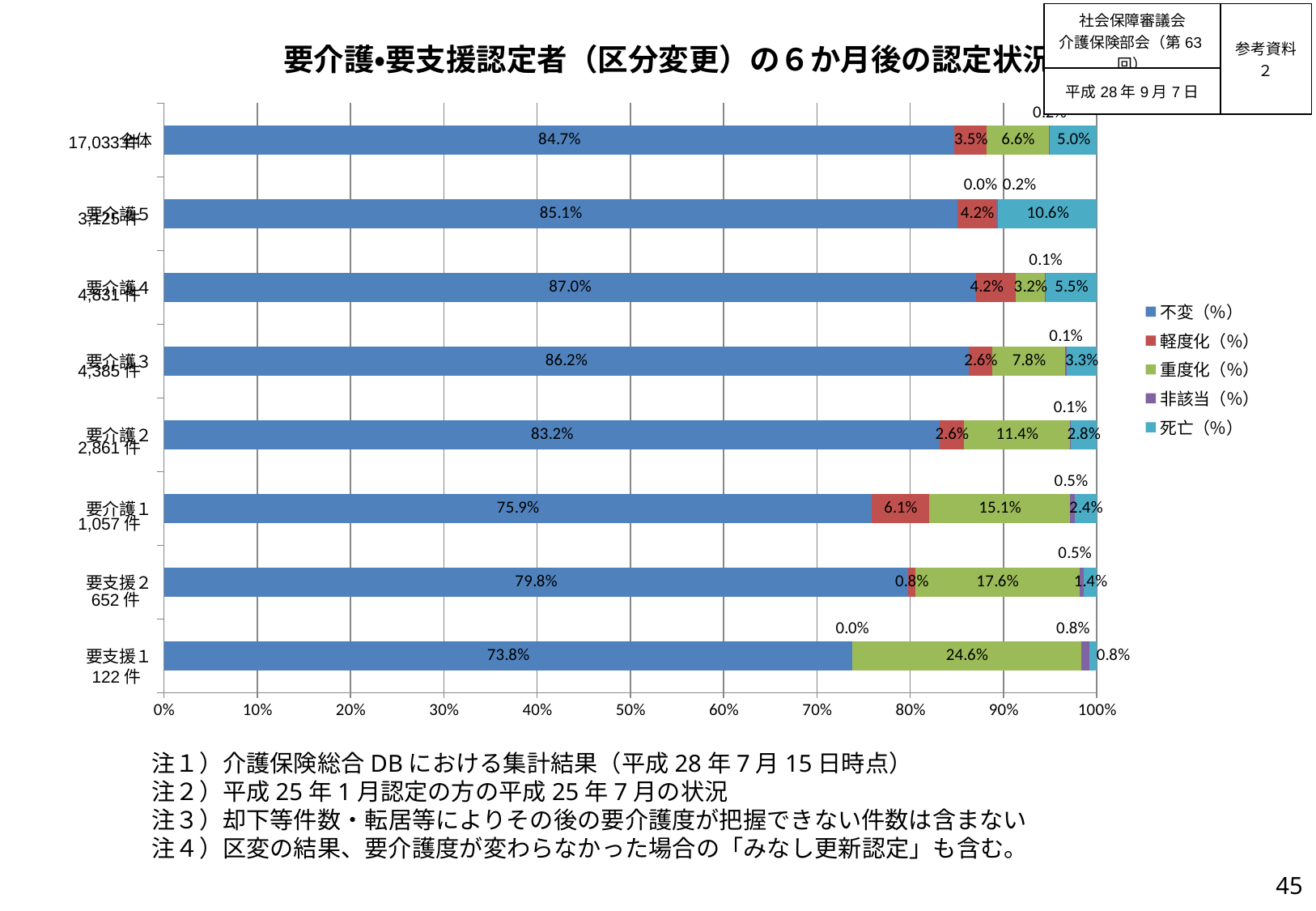
What is the difference between the 重度化（%） values for 要支援2 and 要介護1? 2.5% Which category has the highest 不変（%） value? 要介護4 How many series does the legend list? 5 What type of chart is shown on the slide? stacked bar chart Which category has the lowest 不変（%） value? 要支援1 What is the 不変（%） value for 要介護1? 75.9% What is the 重度化（%） value for 要支援1? 24.6% Which category has the highest 重度化（%） value? 要支援1 What is the 死亡（%） value for 要介護4? 5.5% Which is larger, the 死亡（%） value for 要介護2 or for 要介護1? 要介護2 What is the 軽度化（%） value for 要介護3? 2.6% How many categories (bars) are plotted on the chart? 8